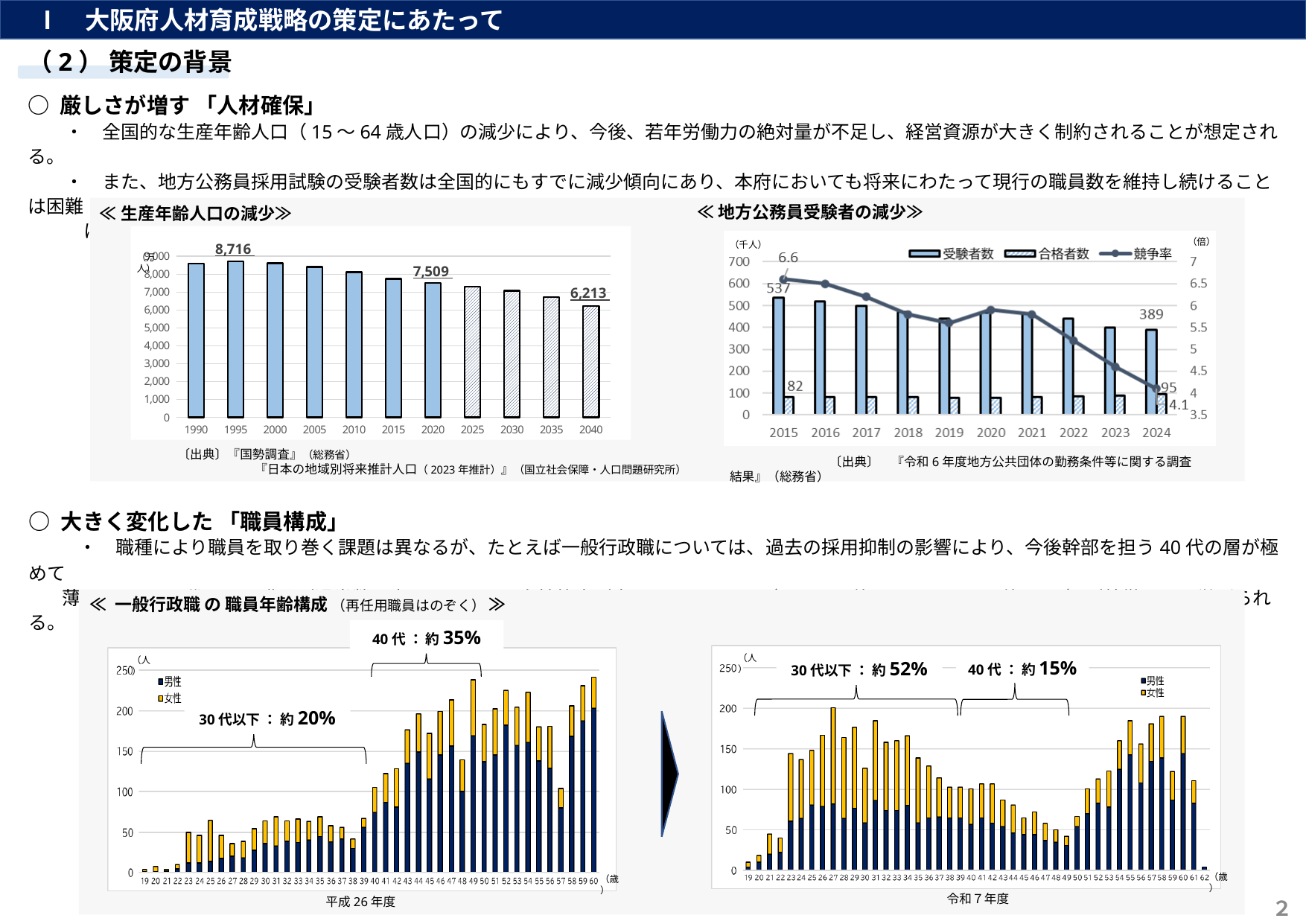
In the 地方公務員受験者の減少 chart, how many series does the legend list? 3 In the 地方公務員受験者の減少 chart, what is the difference between the 受験者数 for 2015 and for 2024? 148 In the 一般行政職の職員年齢構成 chart for 令和7年度, what share of staff is annotated as 30代以下? 約52% In the 生産年齢人口の減少 chart, do the values rise or fall from 1995 to 2040? fall In the 地方公務員受験者の減少 chart, which is larger, the 合格者数 for 2015 or for 2024? 2024 In the 生産年齢人口の減少 chart, what is the difference between the 1995 value and the 2040 value? 2,503 In the 地方公務員受験者の減少 chart, what is the 受験者数 value for 2015? 537 In the 生産年齢人口の減少 chart, what is the value shown for 1995? 8,716 In the 生産年齢人口の減少 chart, how many years are plotted on the x axis? 11 In the 生産年齢人口の減少 chart, what is the value shown for 2040? 6,213 In the 地方公務員受験者の減少 chart, what is the 競争率 value for 2024? 4.1 In the 生産年齢人口の減少 chart, is the value for 2030 greater or less than 8,000? less